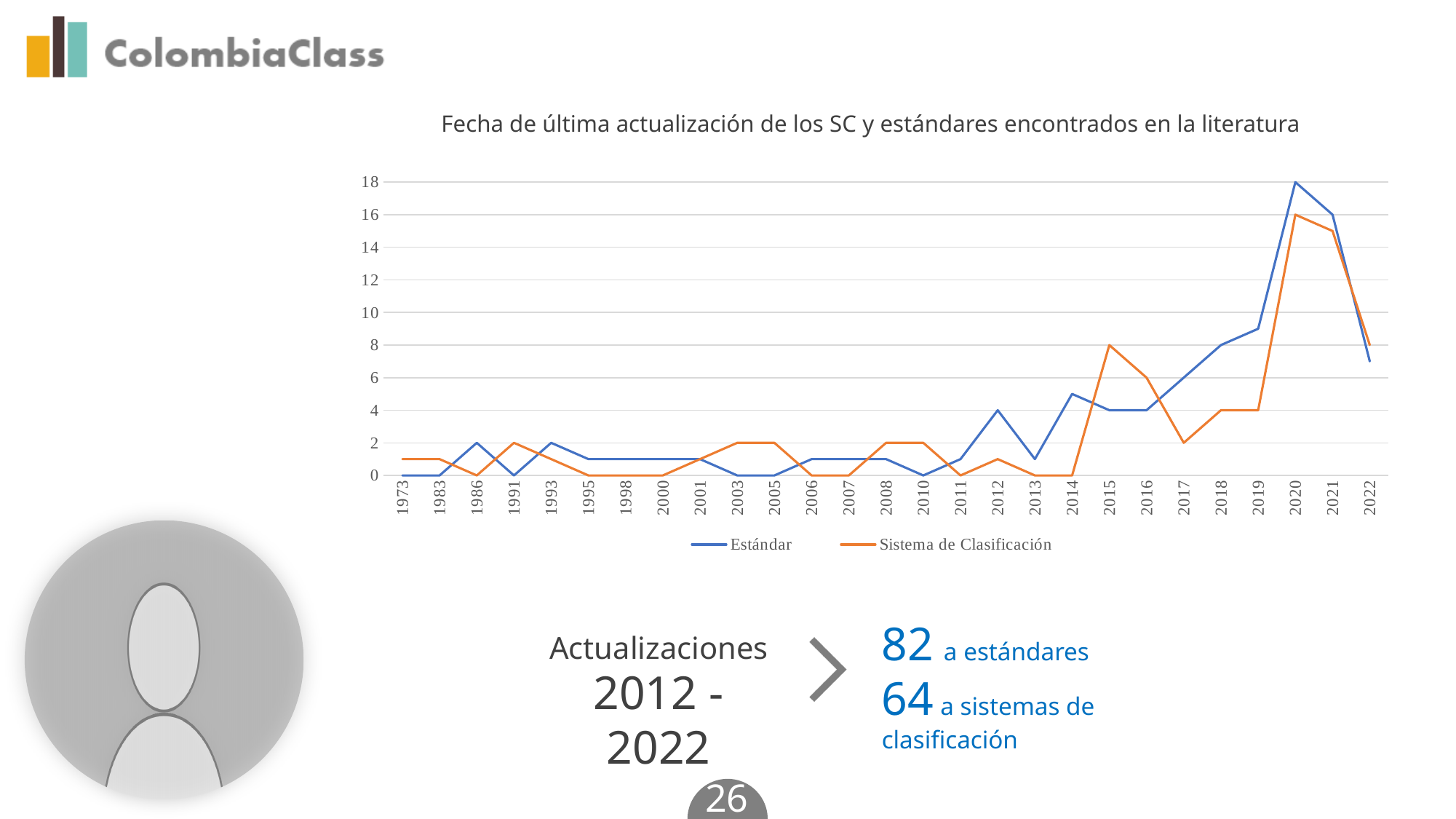
In which year does the Estándar series reach its highest value? 2020 How many years are shown on the x axis? 27 Is the value of the Estándar series in 2019 greater or less than 8? greater What kind of chart is shown on the slide? line chart What is the value of the Sistema de Clasificación series in 2020? 16 What is the value of the Sistema de Clasificación series in 2015? 8 What is the difference between the Estándar and Sistema de Clasificación values in 2020? 2 In 2015, which series has the larger value, Estándar or Sistema de Clasificación? Sistema de Clasificación What are the two series named in the legend? Estándar and Sistema de Clasificación What is the value of the Estándar series in 2020? 18 Does the Estándar series rise or fall from 2017 to 2020? rise How many series does the legend list? 2